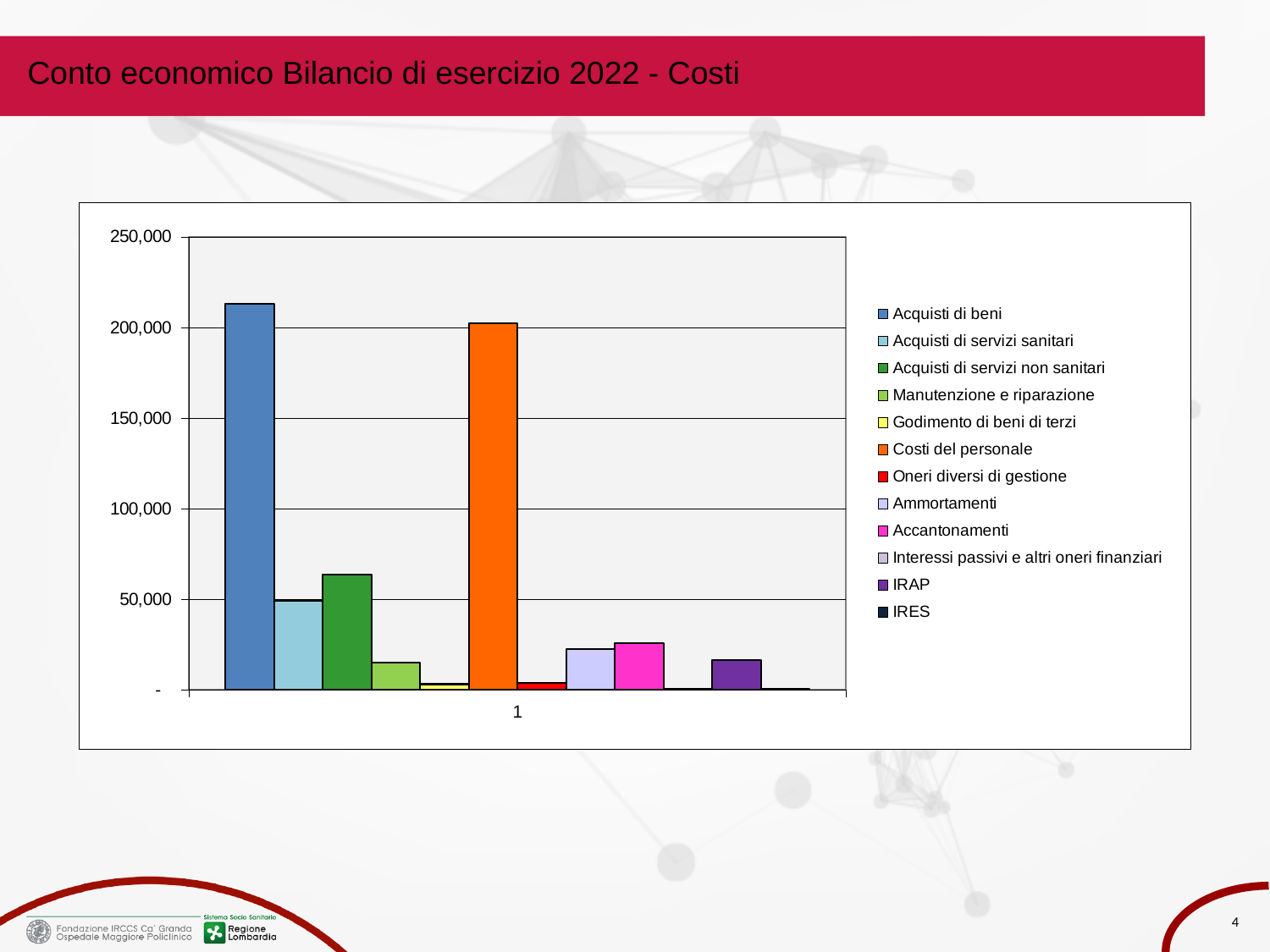
What kind of chart is shown on the slide? bar chart Which is larger, Acquisti di beni or Costi del personale? Acquisti di beni Which series has the highest bar? Acquisti di beni How many series does the legend list? 12 Is the value for IRAP greater or less than 50,000? less Is the value for Costi del personale greater or less than 150,000? greater Is the value for Acquisti di beni greater or less than 200,000? greater Which is larger, Acquisti di servizi sanitari or Acquisti di servizi non sanitari? Acquisti di servizi non sanitari What is the title of the slide containing the chart? Conto economico Bilancio di esercizio 2022 - Costi How many categories are shown on the x axis? 1